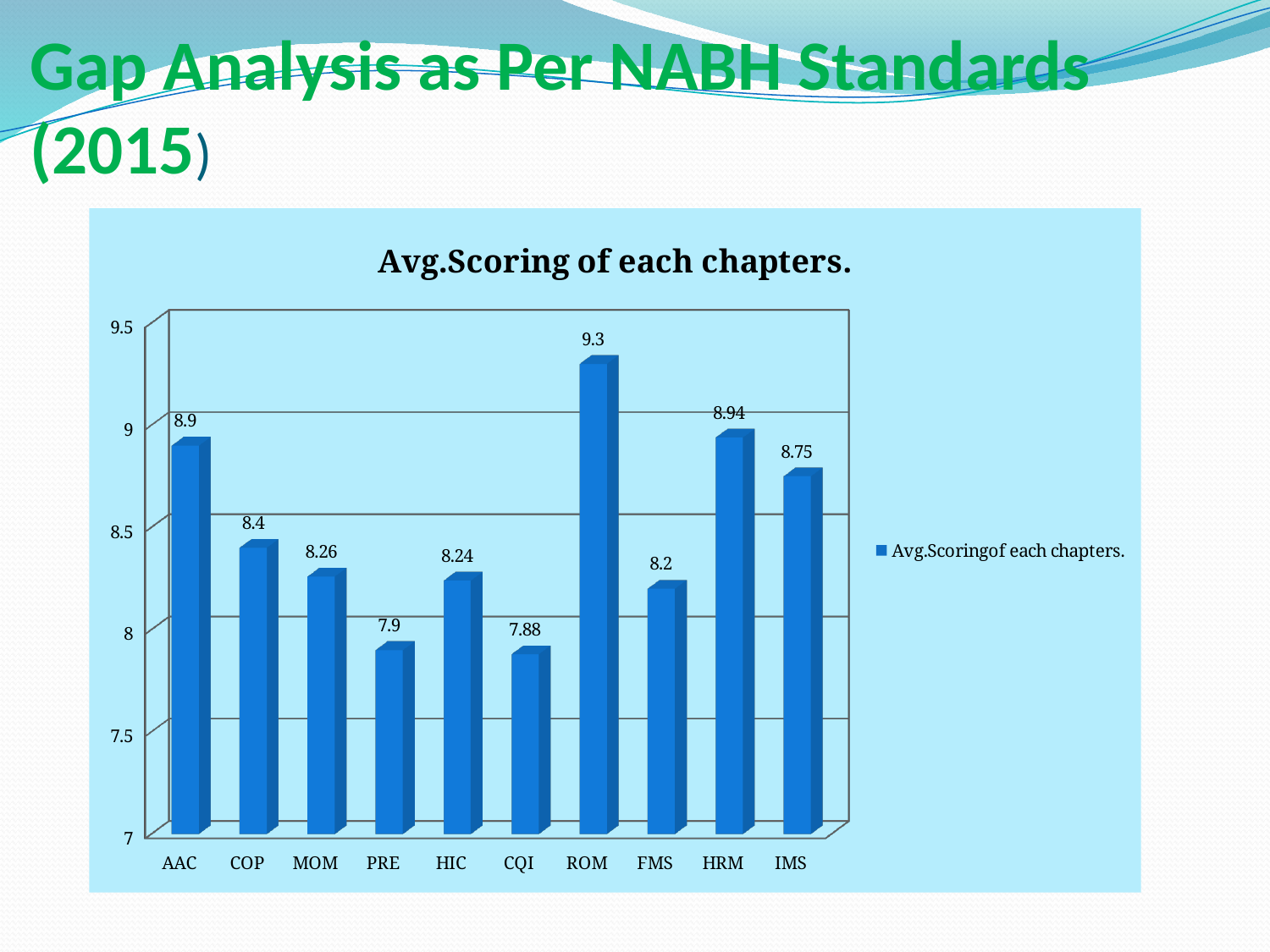
How many chapters are shown on the x axis? 10 What is the title of the chart? Avg.Scoring of each chapters. What is the average score for ROM? 9.3 What is the difference between the average scores of ROM and CQI? 1.42 Which chapter has the lowest average score? CQI What is the difference between the average scores of AAC and COP? 0.5 Is the value for FMS greater or less than 8.5? less Which chapter has the highest average score? ROM What type of chart is shown on the slide? bar chart Which has a higher average score, HRM or IMS? HRM What is the average score for HRM? 8.94 What is the average score for PRE? 7.9